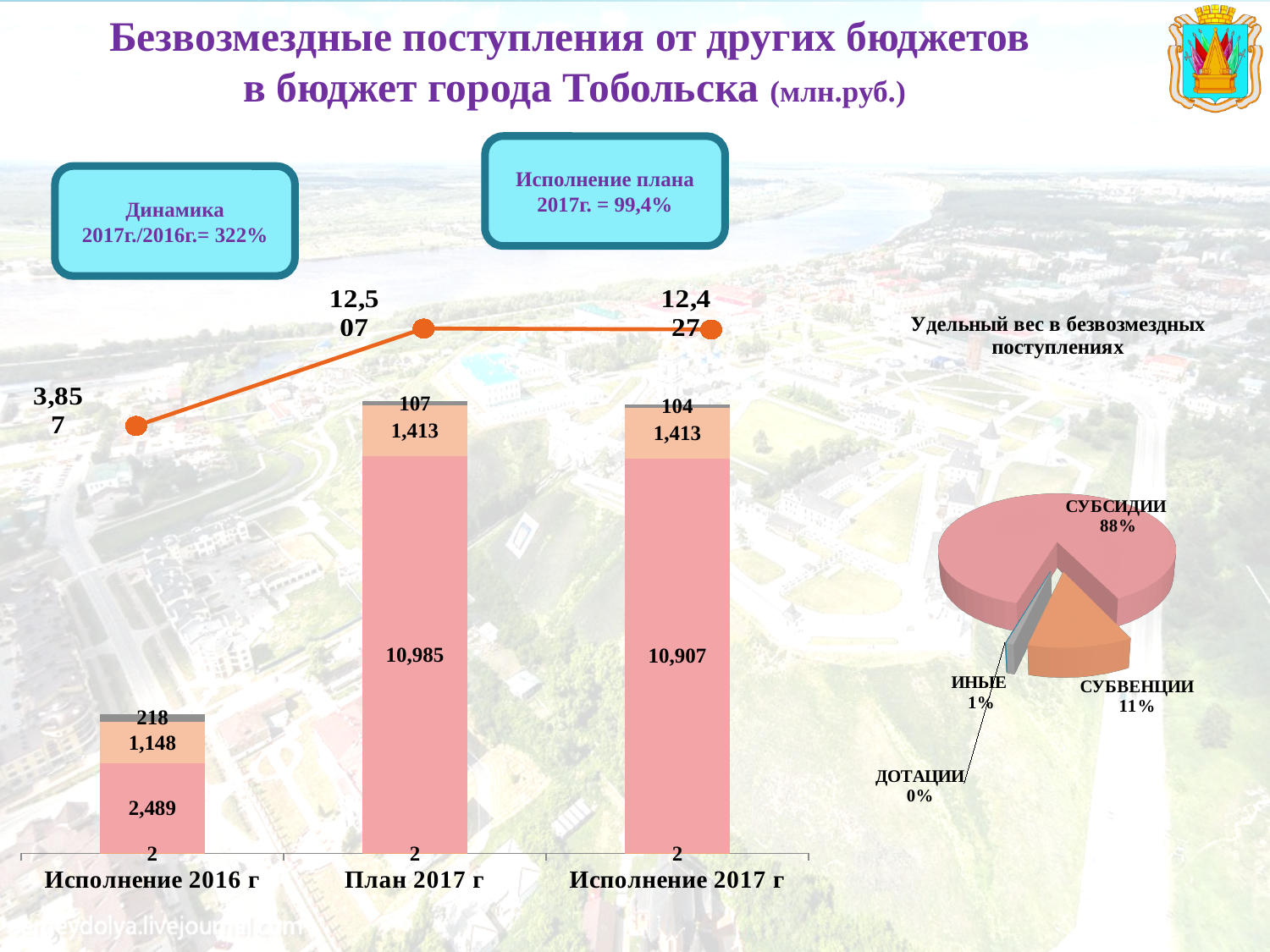
In the stacked bar chart, what is the difference between the bottom pink segment of План 2017 г and that of Исполнение 2017 г? 78 In the stacked bar chart, what is the value of the top (grey) segment for Исполнение 2016 г? 218 In the stacked bar chart, what is the value of the largest (bottom pink) segment for План 2017 г? 10,985 In the pie chart 'Удельный вес в безвозмездных поступлениях', what share do СУБВЕНЦИИ have? 11% In the stacked bar chart, what is the value of the largest (bottom pink) segment for Исполнение 2017 г? 10,907 In the pie chart 'Удельный вес в безвозмездных поступлениях', what share do СУБСИДИИ have? 88% In the stacked bar chart, what is the difference between the top grey segment of Исполнение 2016 г and that of План 2017 г? 111 In the stacked bar chart, what is the total of the bar for Исполнение 2016 г? 3,857 In the stacked bar chart, what is the value of the orange (second from top) segment for Исполнение 2016 г? 1,148 In the pie chart 'Удельный вес в безвозмездных поступлениях', which slice is the largest? СУБСИДИИ How many categories are shown on the x axis of the stacked bar chart? 3 In the stacked bar chart, which category has the lowest total bar? Исполнение 2016 г